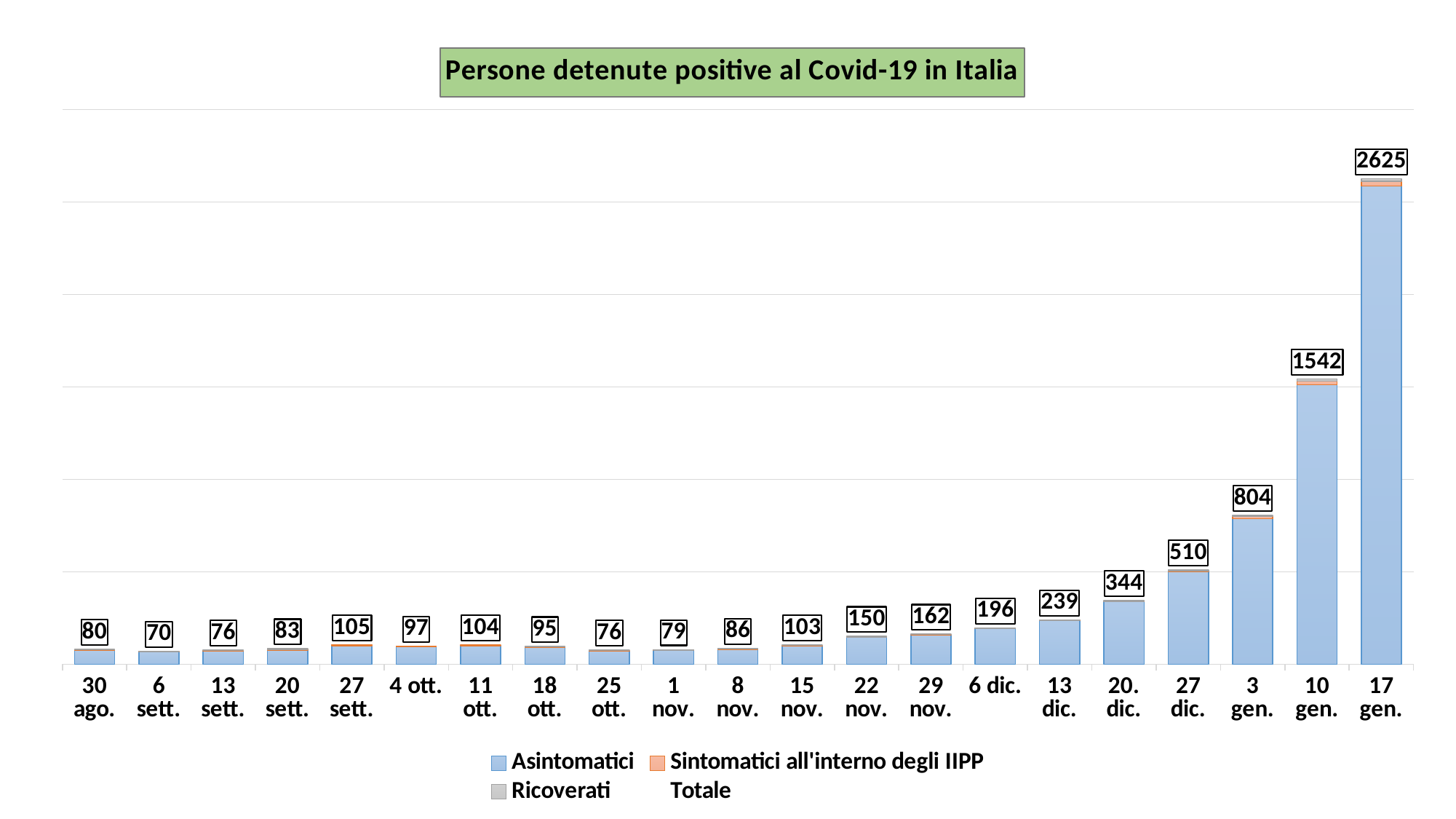
How many dates are shown on the x axis? 21 What is the total value labelled for 22 nov.? 150 What is the total value labelled for 27 dic.? 510 Which date has the lowest total of positive detainees? 6 sett. What is the difference between the totals for 3 gen. and 27 dic.? 294 Which date has the highest total of positive detainees? 17 gen. Do the totals generally rise or fall from 6 dic. to 17 gen.? Rise What kind of chart is shown on the slide? Stacked bar chart What is the difference between the totals for 17 gen. and 10 gen.? 1083 What is the total number of positive detainees shown for 17 gen.? 2625 How many series does the legend list? 4 Which is larger, the total for 27 sett. or the total for 4 ott.? 27 sett.